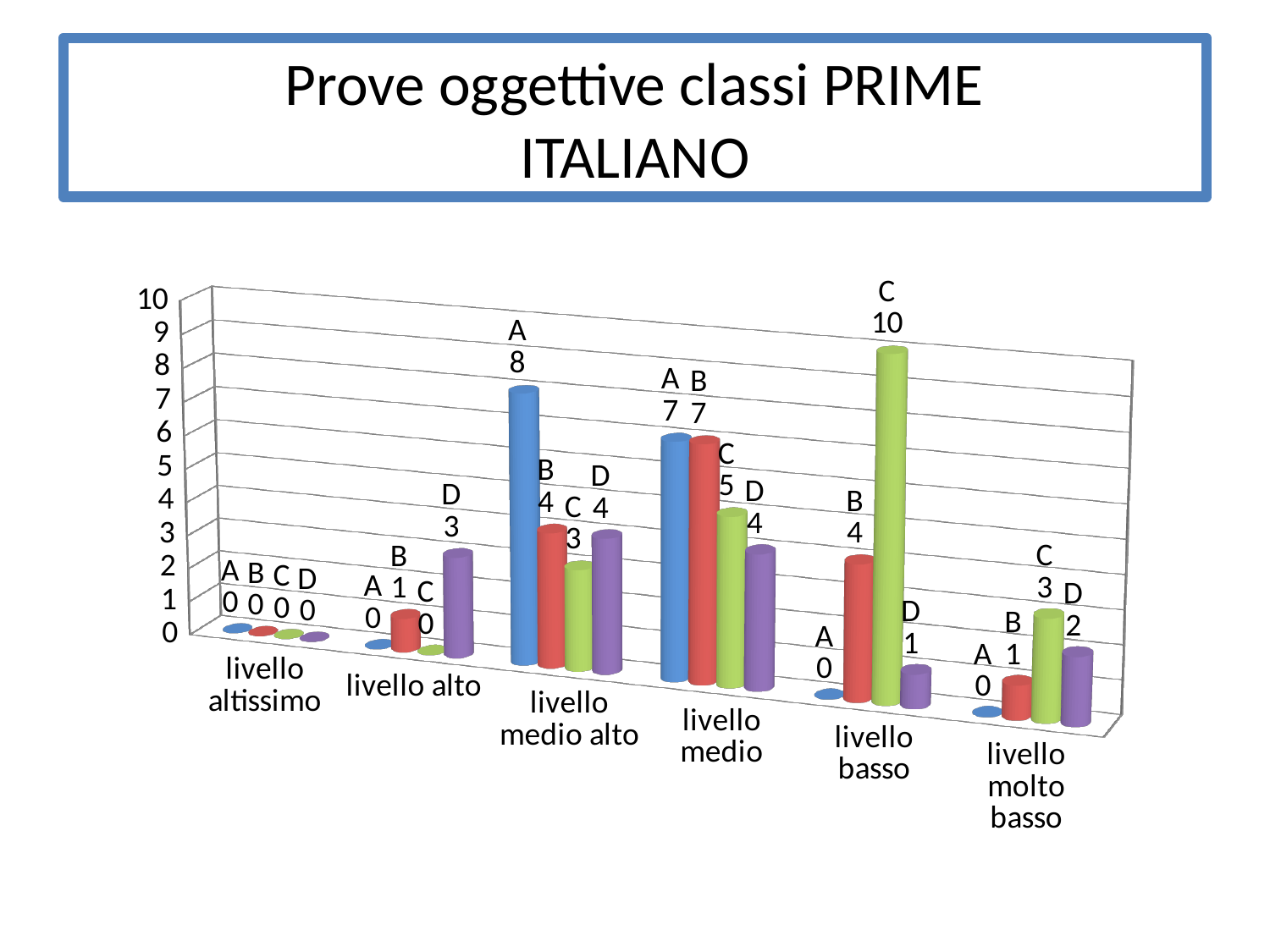
What kind of chart is shown on the slide? bar chart Which is larger at livello medio: series B or series C? series B What is the value for series C at livello basso? 10 What is the value for series A at livello medio alto? 8 What is the difference between series A and series C at livello medio alto? 5 How many categories are shown on the x axis? 6 What is the value for series D at livello alto? 3 Which category has the highest value for series A? livello medio alto Which category has the highest value for series C? livello basso What is the difference between series C and series B at livello basso? 6 What is the value for series B at livello molto basso? 1 What is the title of the slide? Prove oggettive classi PRIME ITALIANO